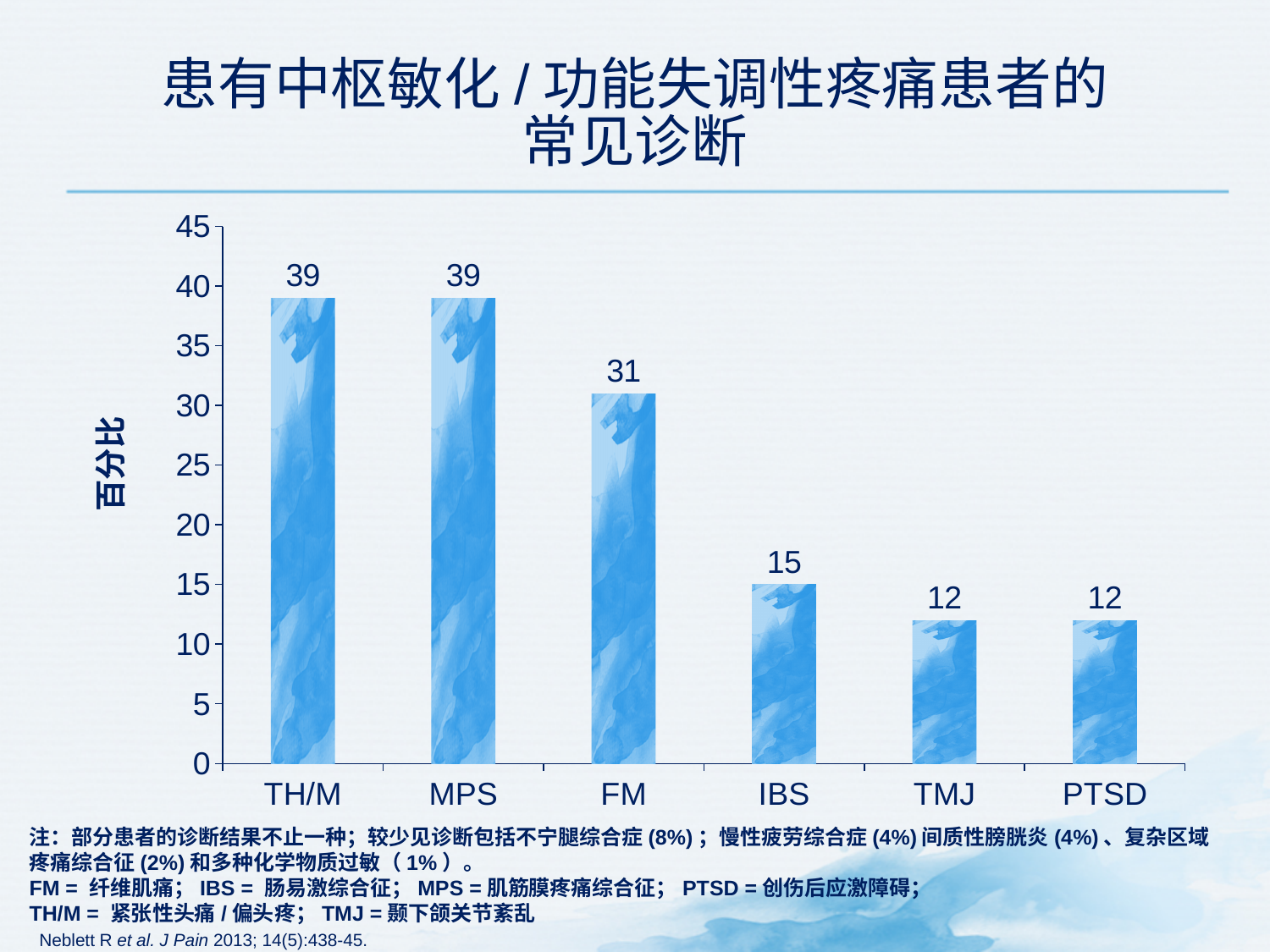
What is the label of the y axis? 百分比 What is the difference between the values for IBS and PTSD? 3 What is the difference between the values for TH/M and FM? 8 What is the lowest value shown in the chart? 12 What is the highest value shown in the chart? 39 What kind of chart is shown on the slide? Bar chart How many categories are shown on the x axis? 6 What is the value for MPS? 39 Which is larger, the value for FM or the value for IBS? FM What is the value for FM? 31 What is the value for TMJ? 12 What is the value for IBS? 15